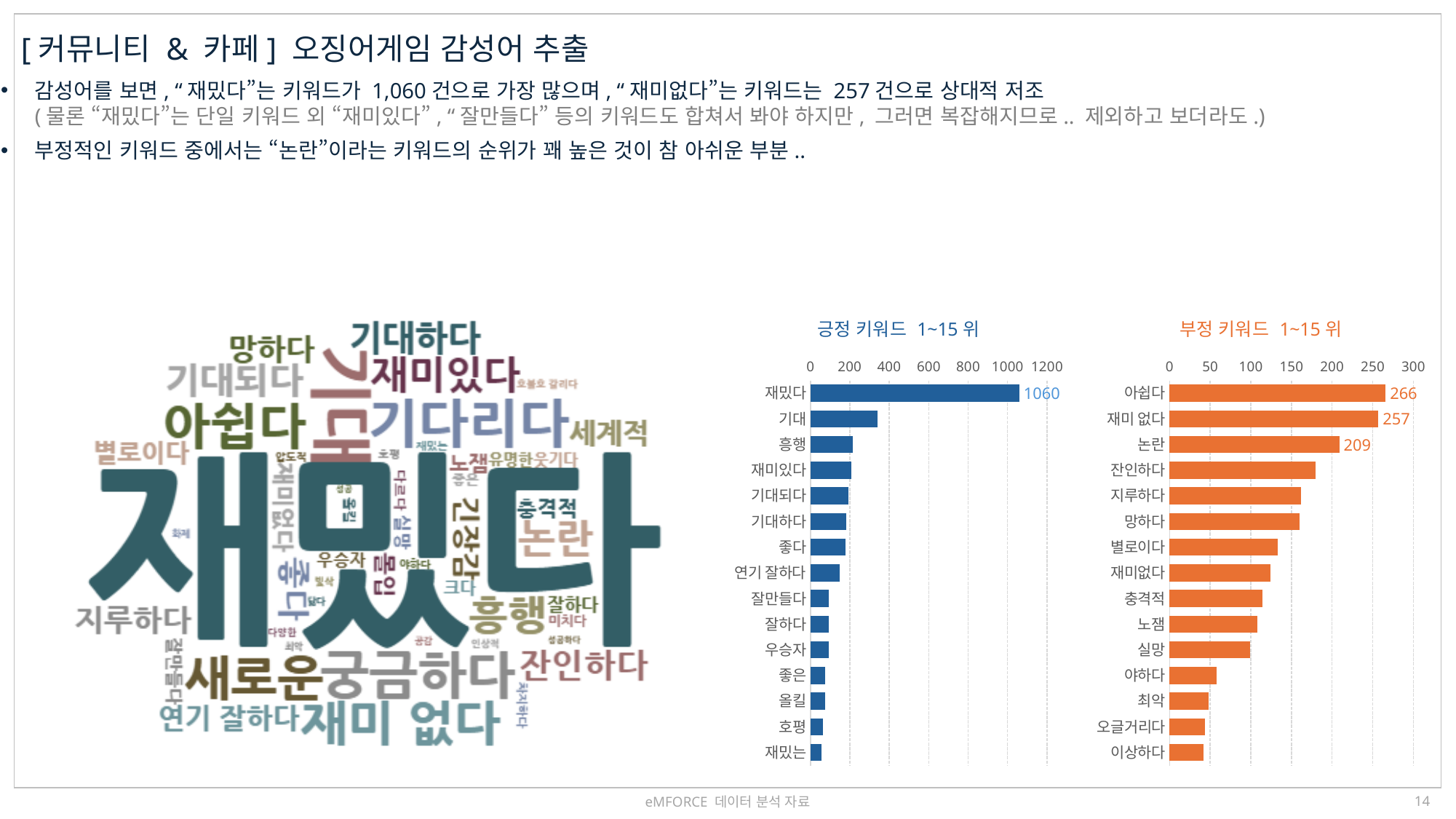
In the '긍정 키워드 1~15 위' chart, is the value for 기대 greater or less than 200? greater In the '부정 키워드 1~15 위' chart, is the value for 잔인하다 greater or less than 200? less In the '부정 키워드 1~15 위' chart, what is the value for 논란? 209 In the '긍정 키워드 1~15 위' chart, what is the value for 재밌다? 1060 In the '부정 키워드 1~15 위' chart, which keyword has the highest value? 아쉽다 In the '부정 키워드 1~15 위' chart, what is the value for 아쉽다? 266 In the '부정 키워드 1~15 위' chart, what is the difference between the values for 아쉽다 and 논란? 57 In the '긍정 키워드 1~15 위' chart, which keyword has the highest value? 재밌다 What type of chart is the '부정 키워드 1~15 위' chart? Bar chart In the '부정 키워드 1~15 위' chart, what is the difference between the values for 재미 없다 and 논란? 48 In the '부정 키워드 1~15 위' chart, what is the value for 재미 없다? 257 How many keywords are shown in the '긍정 키워드 1~15 위' chart? 15